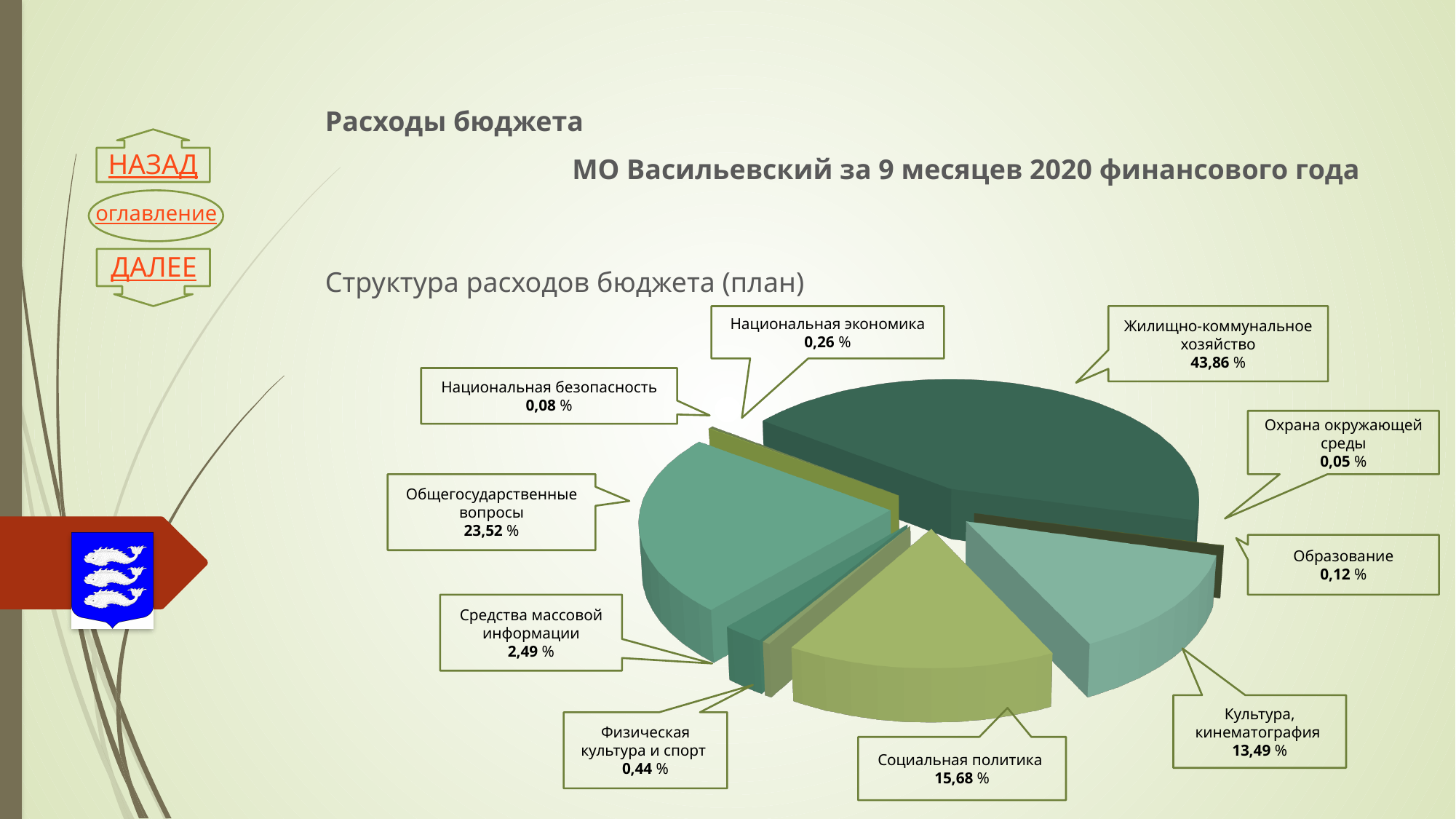
What is the share of Жилищно-коммунальное хозяйство in the pie chart? 43,86 % Which category has the largest share of the pie? Жилищно-коммунальное хозяйство What is the share of Общегосударственные вопросы? 23,52 % Which is larger: the share of Социальная политика or Культура, кинематография? Социальная политика How many categories are shown in the pie chart? 10 What is the difference between the shares of Жилищно-коммунальное хозяйство and Общегосударственные вопросы? 20,34 % What is the title of the chart? Структура расходов бюджета (план) What is the share of Средства массовой информации? 2,49 % What kind of chart is shown on the slide? Pie chart What is the share of Социальная политика? 15,68 % Which category has the smallest share of the pie? Охрана окружающей среды What is the share of Охрана окружающей среды? 0,05 %